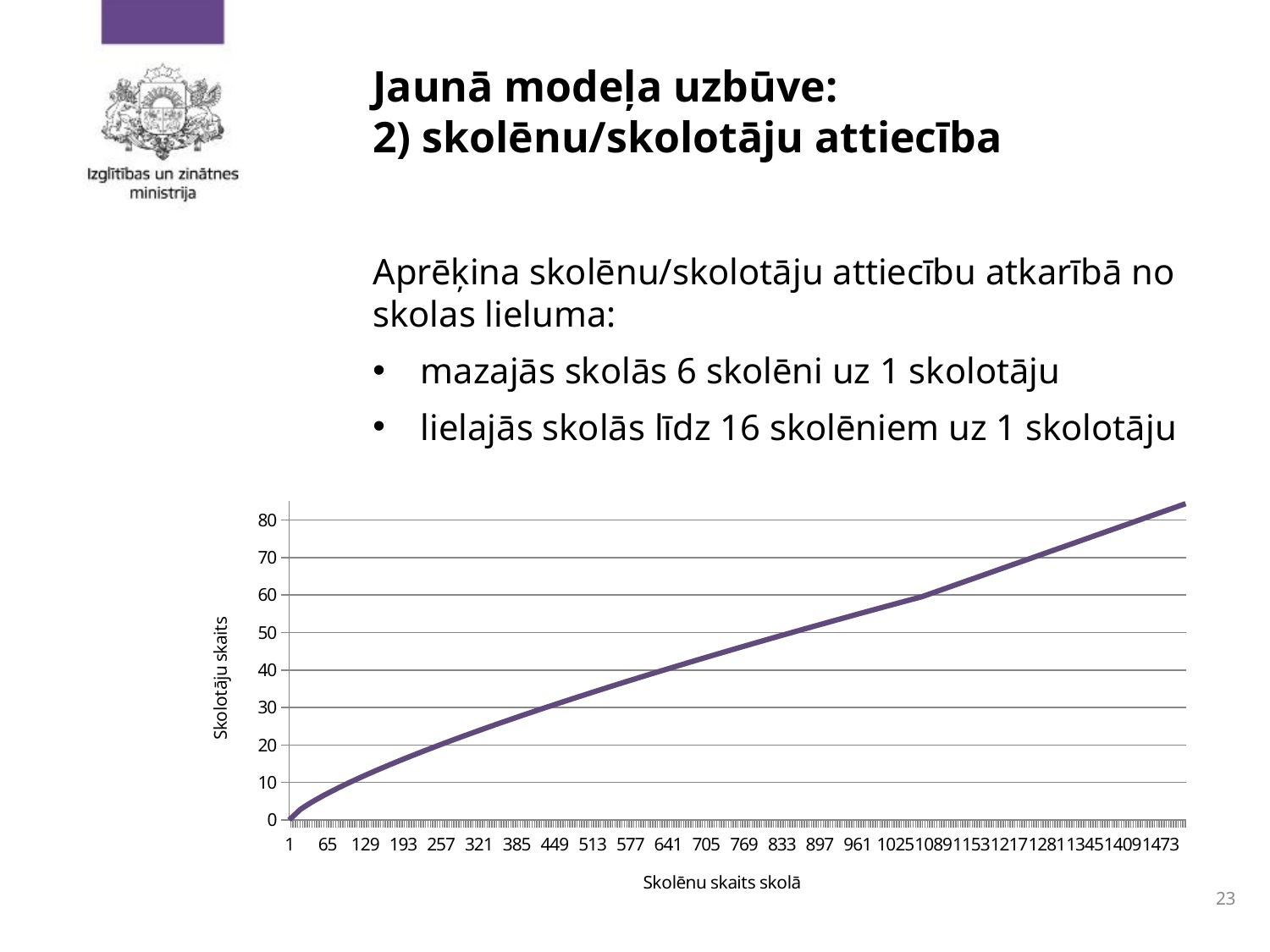
What is the title of the vertical axis? Skolotāju skaits Is the value for 769 students greater or less than 40? greater Is the value for 65 students greater or less than 10? less Is the value for 385 students greater or less than 30? less Do the values rise or fall as the number of students (x axis) increases? rise Which of the two values is larger: the value for 257 students or the value for 961 students? 961 students What is the title of the horizontal axis? Skolēnu skaits skolā What kind of chart is shown on the slide? line chart